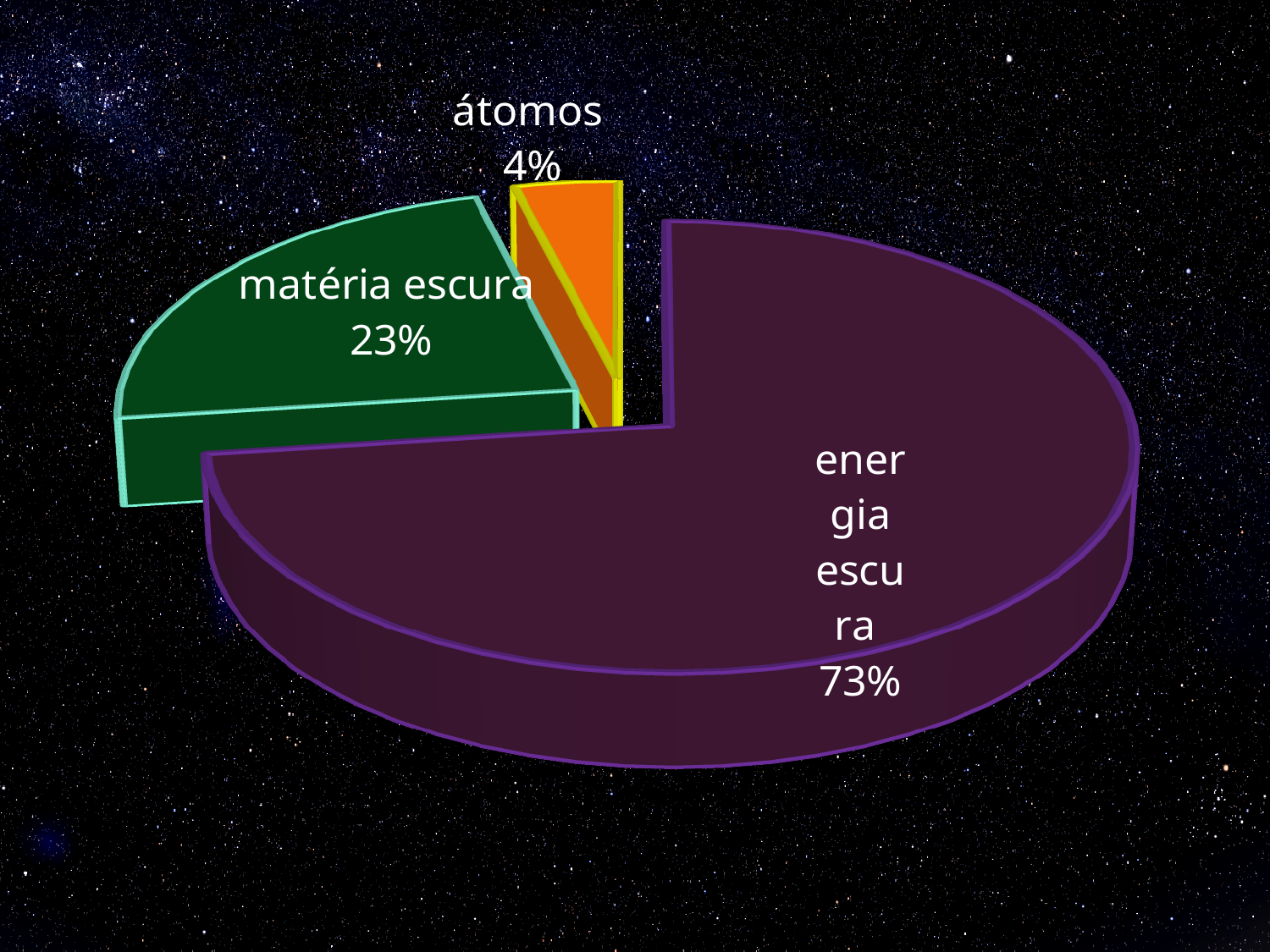
What colour is the 'matéria escura' slice? green What colour is the 'átomos' slice? orange Which slice of the pie is the smallest? átomos What percentage does the 'átomos' slice represent? 4% What is the difference in percentage points between 'matéria escura' and 'átomos'? 19 What percentage does the 'energia escura' slice represent? 73% How many slices does the pie chart have? 3 What is the difference in percentage points between 'energia escura' and 'matéria escura'? 50 What percentage does the 'matéria escura' slice represent? 23% Which slice of the pie is the largest? energia escura Which is larger, the 'matéria escura' slice or the 'átomos' slice? matéria escura What kind of chart is shown on the slide? pie chart